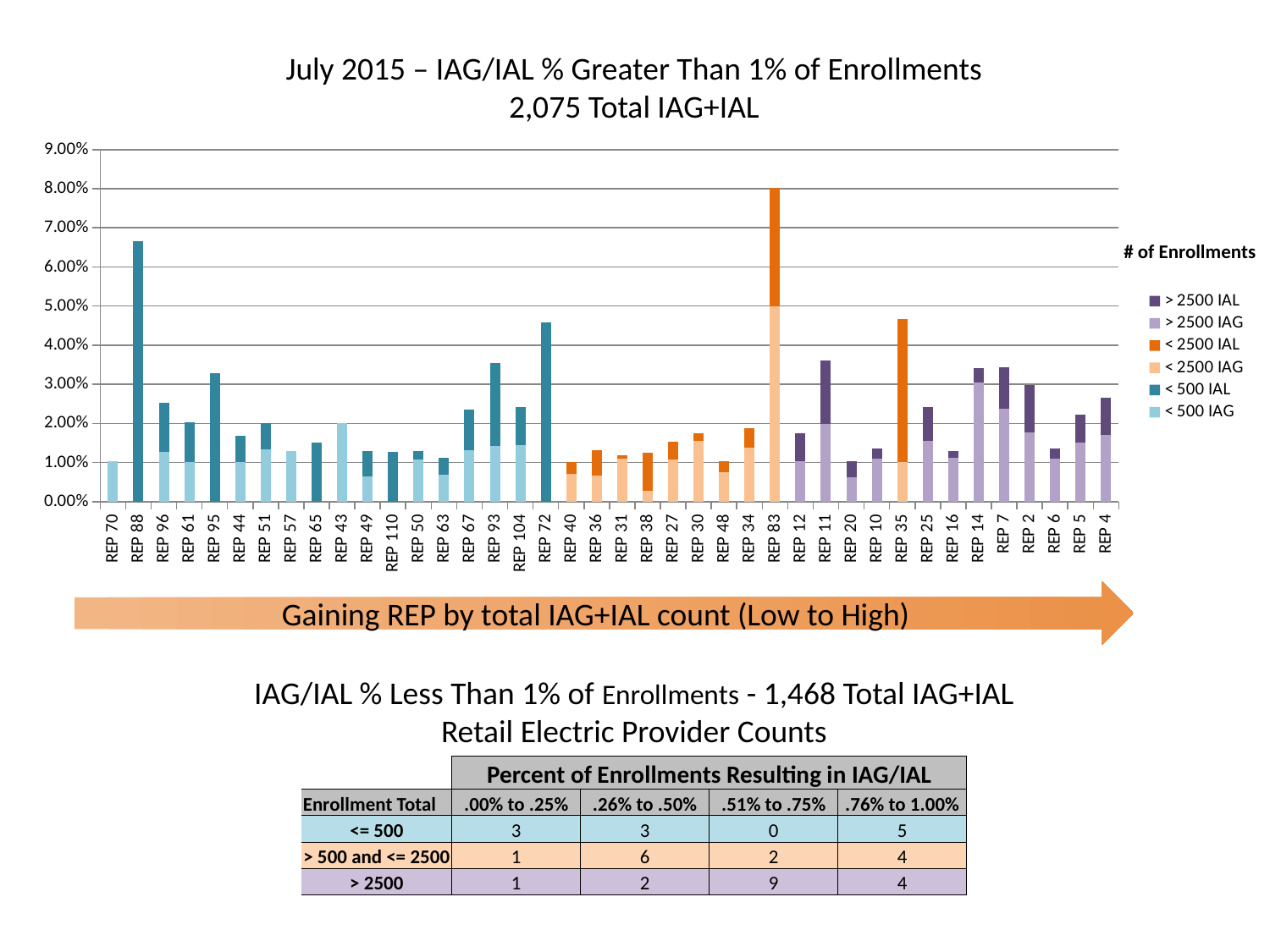
What kind of chart is shown on the slide? Stacked bar chart Which has the taller total bar, REP 88 or REP 72? REP 88 Is the total value for REP 83 greater or less than 7.00%? greater Is the total value for REP 11 greater or less than 3.00%? greater Which REP has the highest total bar in the chart? REP 83 Is the total value for REP 70 greater or less than 2.00%? less How many series does the chart legend list? 6 What is the title shown above the chart legend? # of Enrollments Which has the taller total bar, REP 83 or REP 35? REP 83 How many REP categories are plotted along the x axis of the chart? 40